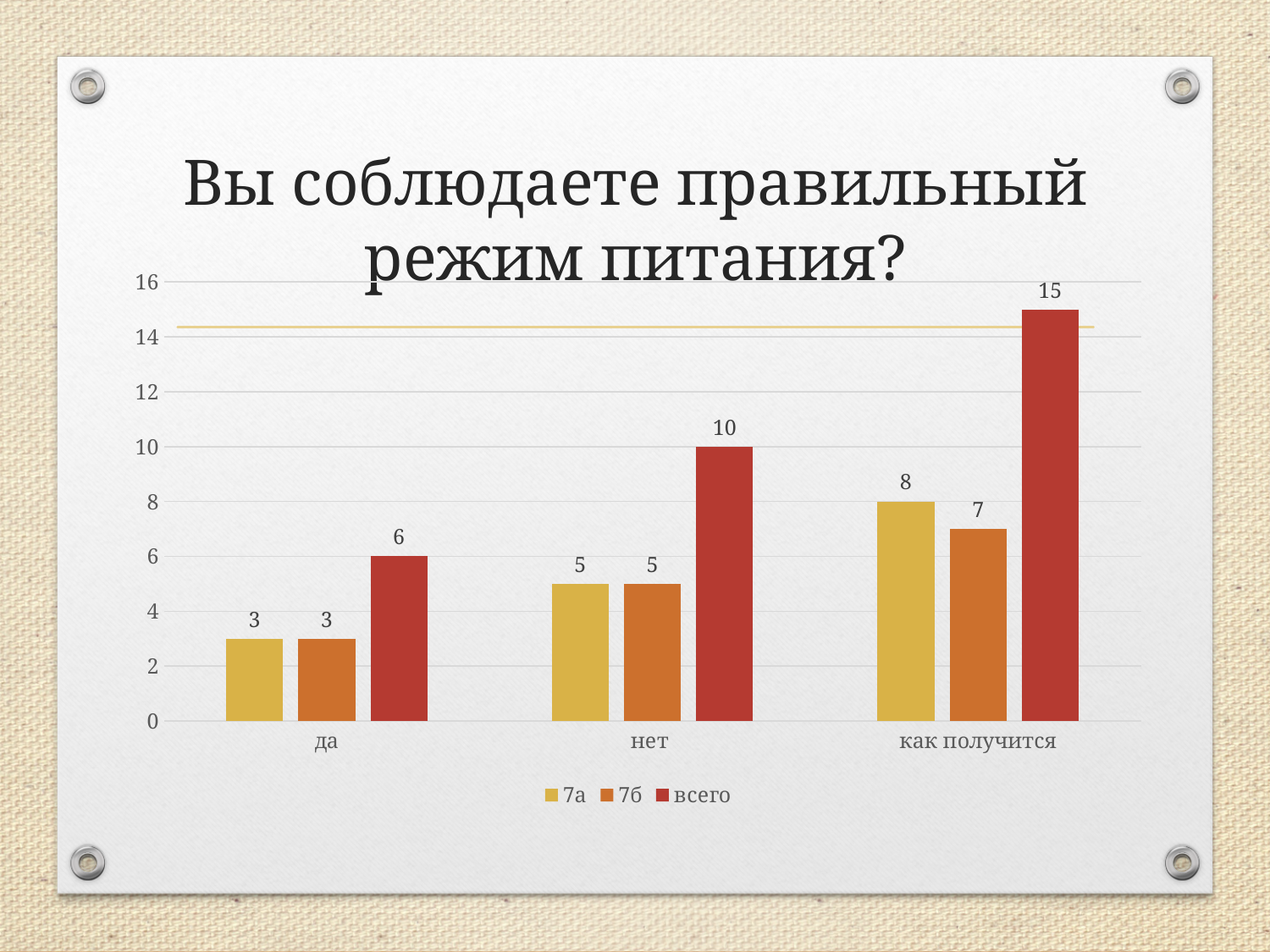
Is the value for всего in 'как получится' greater or less than 14? greater How many series does the legend list? 3 What is the value for 7б in the 'как получится' category? 7 How many categories are shown on the x axis? 3 What is the value for всего in the 'нет' category? 10 Which category has the lowest value for 7а? да Which category has the highest value for всего? как получится What kind of chart is shown on the slide? bar chart What is the value for 7а in the 'да' category? 3 What is the title of the chart? Вы соблюдаете правильный режим питания? Which is larger: the 7а value for 'как получится' or the 7б value for 'как получится'? 7а What is the difference between the всего values for 'как получится' and 'нет'? 5